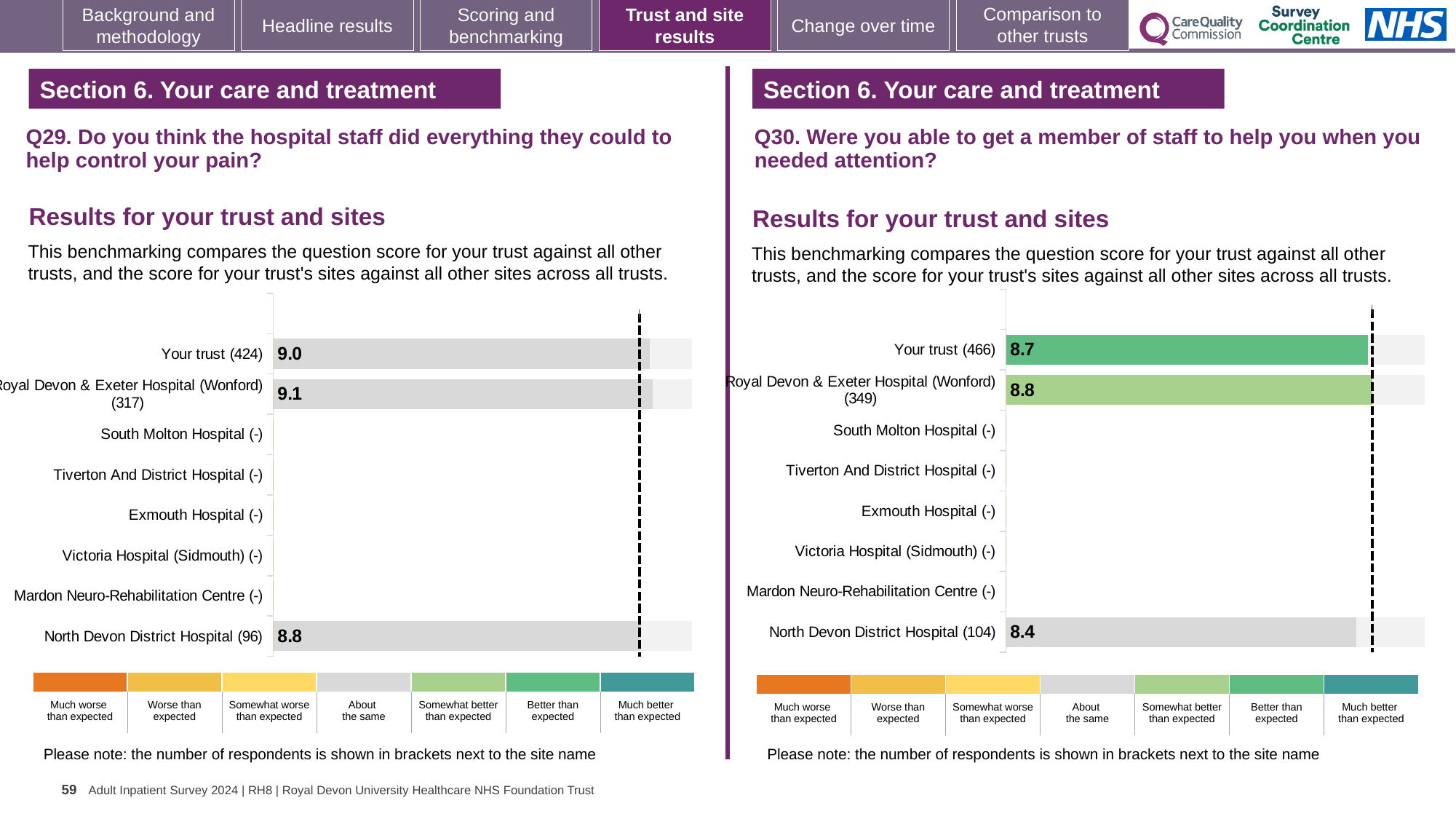
On the Q29 chart (left), which has the higher score: Your trust (424) or North Devon District Hospital (96)? Your trust (424) On the Q30 chart (right), what is the score for Your trust (466)? 8.7 On the Q30 chart (right), what is the score for North Devon District Hospital (104)? 8.4 On the Q30 chart (right), which site or trust has the lowest score? North Devon District Hospital (104) On the Q29 chart (left), what is the score for Royal Devon & Exeter Hospital (Wonford) (317)? 9.1 On the Q29 chart (left), what is the difference between the score for Royal Devon & Exeter Hospital (Wonford) and the score for North Devon District Hospital? 0.3 On the Q30 chart (right), which site or trust has the highest score? Royal Devon & Exeter Hospital (Wonford) (349) On the Q30 chart (right), what is the difference between the score for Your trust and the score for North Devon District Hospital? 0.3 How many site or trust categories are listed on the Q30 chart (right)? 8 On the Q29 chart (left), what is the score for North Devon District Hospital (96)? 8.8 On the Q29 chart (left), what is the score for Your trust (424)? 9.0 What type of chart is used on the Q29 chart (left)? Bar chart